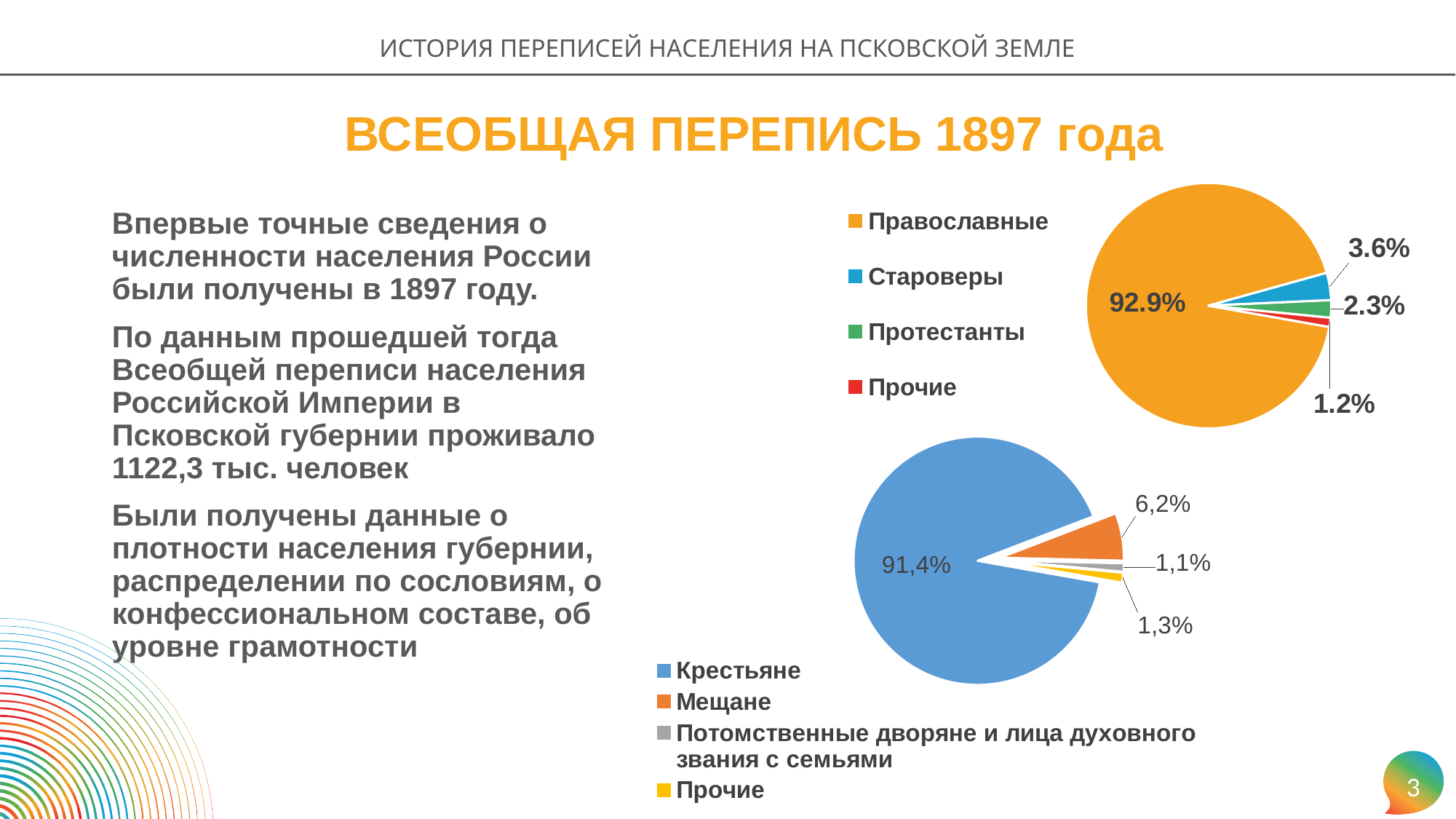
In the upper pie chart, what share is shown for Протестанты? 2.3% In the lower pie chart, what colour is the slice for Крестьяне? Blue In the upper pie chart, what share is shown for Православные? 92.9% In the upper pie chart, what share is shown for Староверы? 3.6% In the upper pie chart, what is the difference between the shares of Староверы and Протестанты? 1.3% In the upper pie chart, which category has the smallest slice? Прочие What kind of chart is the upper chart on the right side of the slide? Pie chart In the lower pie chart, what share is shown for Крестьяне? 91,4% In the upper pie chart, how many categories does the legend list? 4 In the lower pie chart, which category has the smallest slice? Потомственные дворяне и лица духовного звания с семьями In the lower pie chart, which is larger: the share for Прочие or the share for Потомственные дворяне и лица духовного звания с семьями? Прочие In the lower pie chart, what share is shown for Мещане? 6,2%